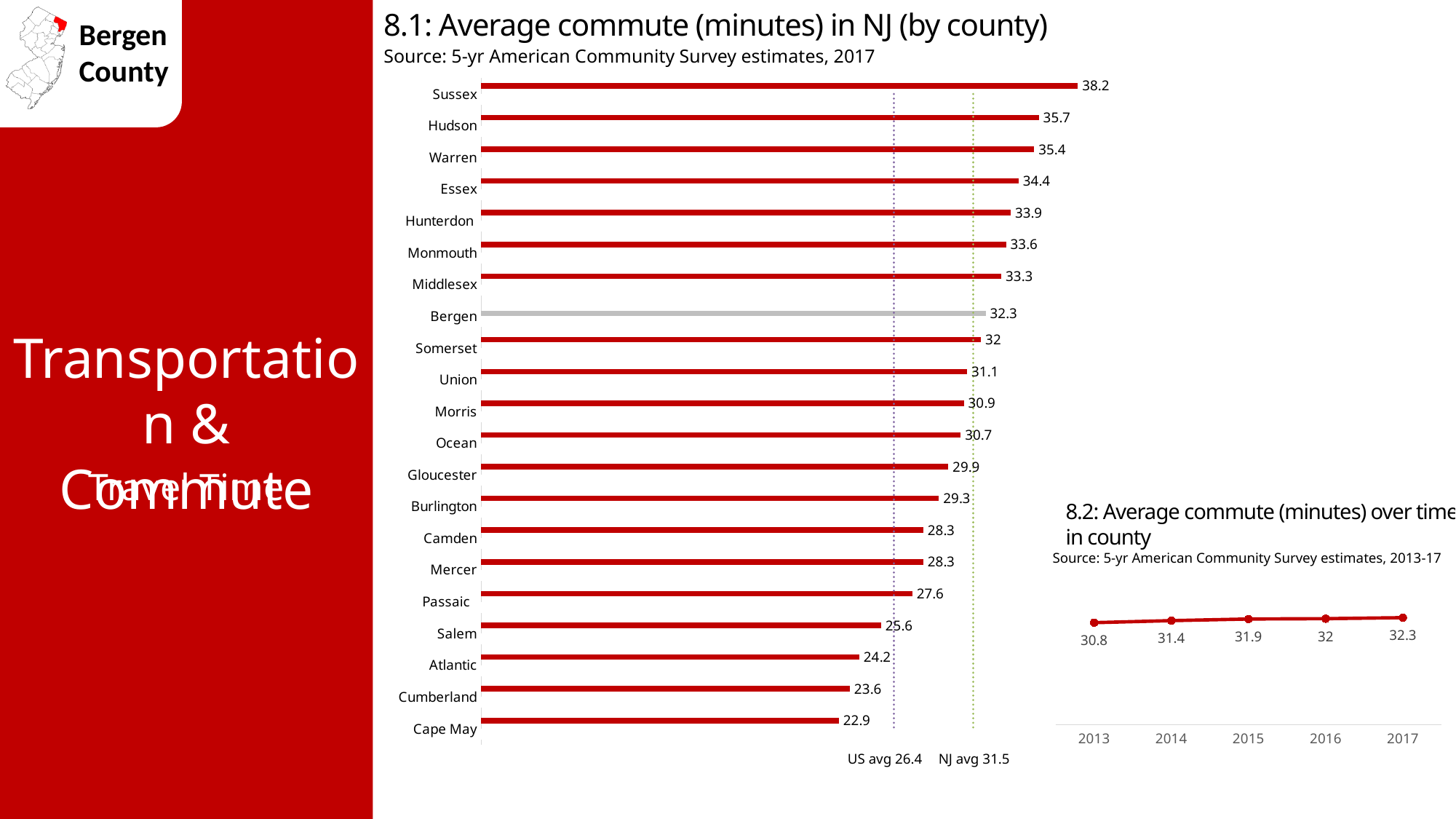
In chart 8.2 (Average commute over time in county), what is the value for 2013? 30.8 In chart 8.2 (Average commute over time in county), do the values rise or fall from 2013 to 2017? Rise In chart 8.1 (Average commute in NJ by county), what is the NJ average shown by the dotted reference line? 31.5 What kind of chart is chart 8.1 (Average commute in NJ by county)? Bar chart In chart 8.1 (Average commute in NJ by county), what is the difference between Sussex and Cape May? 15.3 In chart 8.1 (Average commute in NJ by county), what is the average commute for Bergen? 32.3 In chart 8.1 (Average commute in NJ by county), how many counties are shown? 21 In chart 8.1 (Average commute in NJ by county), which county has the highest average commute? Sussex In chart 8.2 (Average commute over time in county), what is the difference between 2017 and 2013? 1.5 In chart 8.1 (Average commute in NJ by county), which has a longer average commute, Essex or Morris? Essex In chart 8.1 (Average commute in NJ by county), what is the average commute for Hudson? 35.7 In chart 8.1 (Average commute in NJ by county), which county has the lowest average commute? Cape May